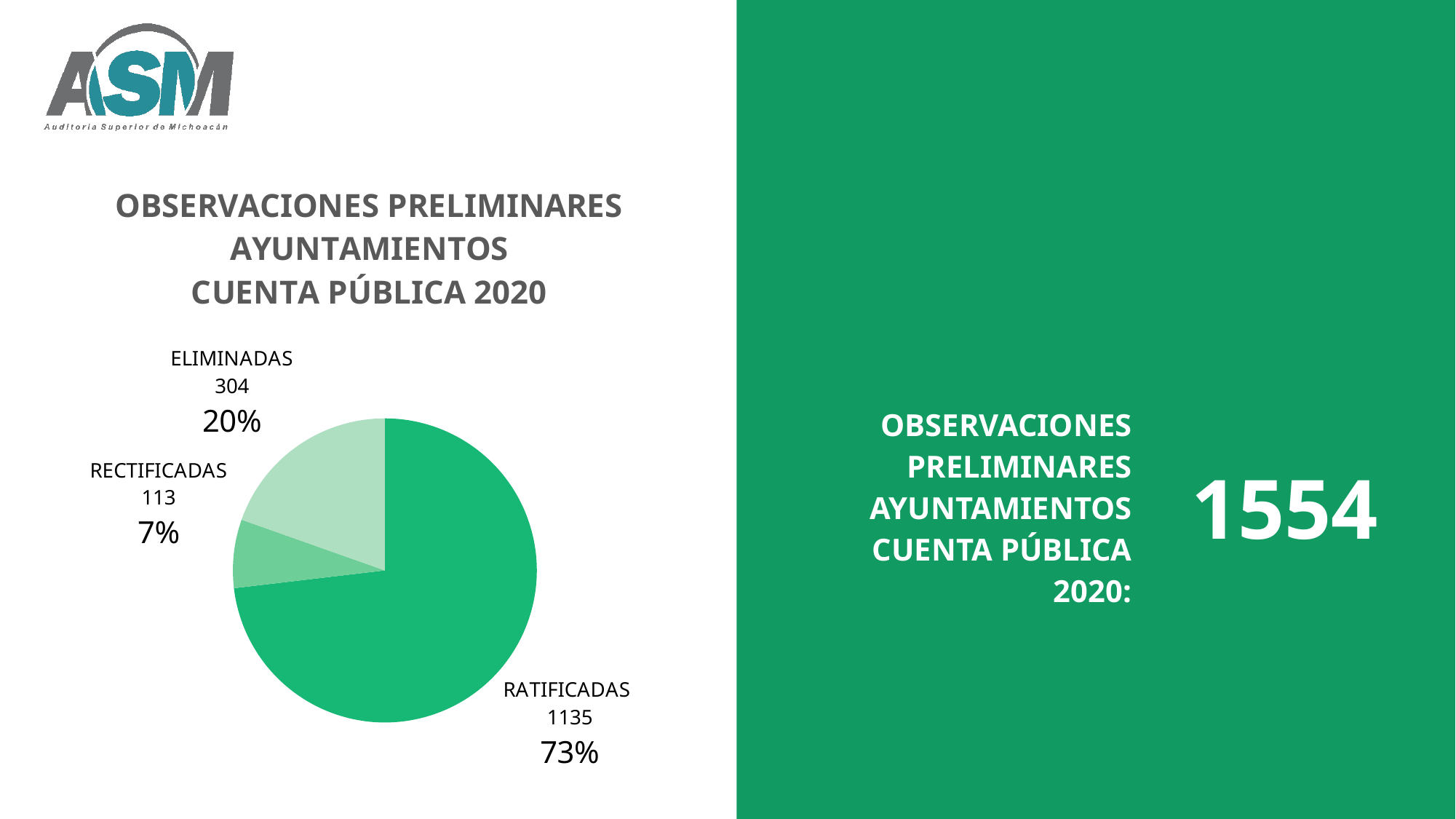
Which is larger, ELIMINADAS or RECTIFICADAS? ELIMINADAS What is the difference between the values for RATIFICADAS and ELIMINADAS? 831 What kind of chart is shown on the slide? pie chart What is the value for ELIMINADAS? 304 What share of the pie does ELIMINADAS represent? 20% Which category has the largest slice? RATIFICADAS What is the value for RECTIFICADAS? 113 Which category has the smallest slice? RECTIFICADAS What is the value for RATIFICADAS? 1135 What share of the pie does RECTIFICADAS represent? 7% What share of the pie does RATIFICADAS represent? 73% How many slices does the pie chart have? 3